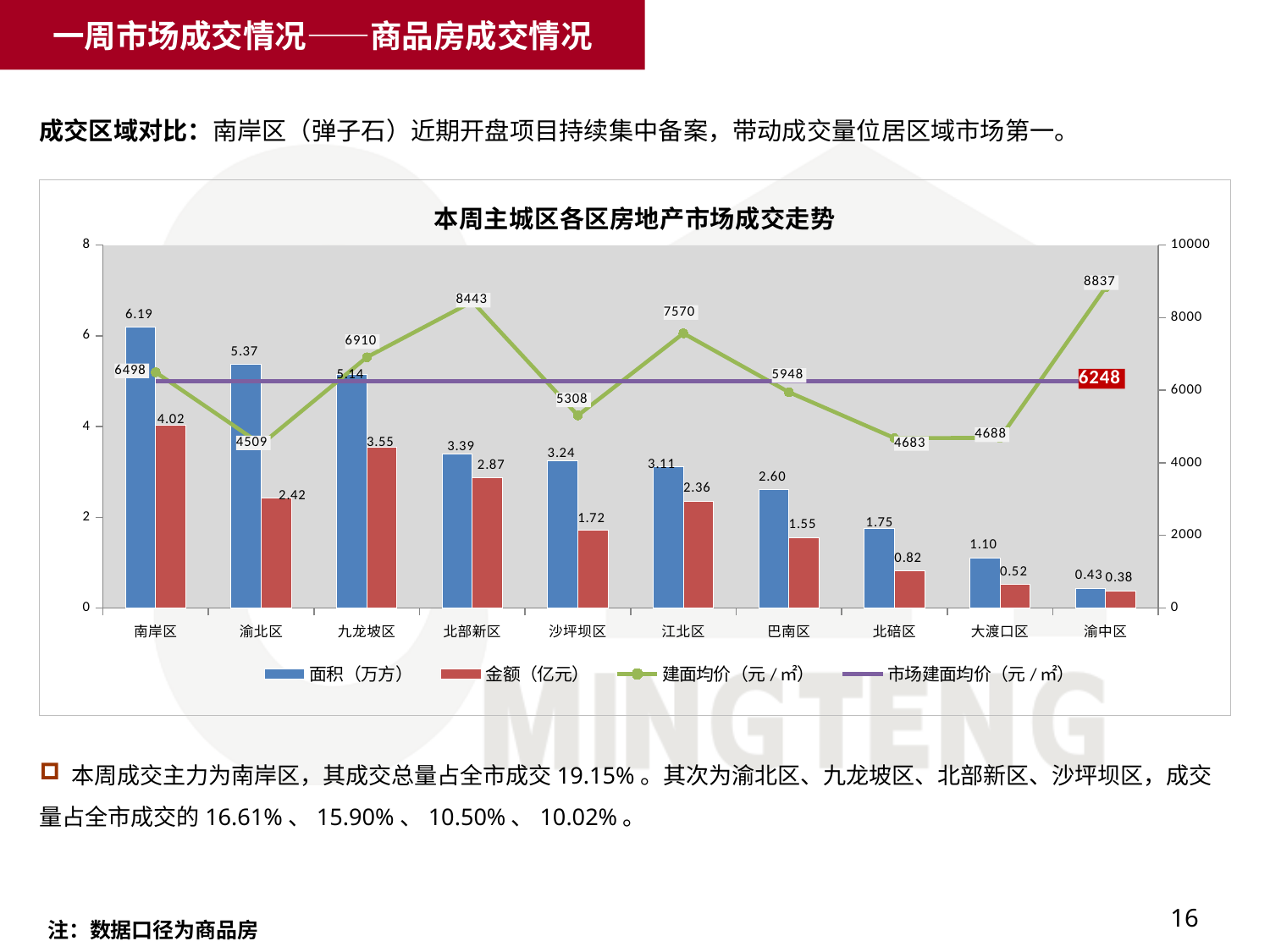
What is the value of the 市场建面均价（元/㎡） line? 6248 Which district has the highest 建面均价（元/㎡）? 渝中区 What is the 金额（亿元） value for 九龙坡区? 3.55 How many series does the legend list? 4 What kind of chart is this? Combined bar and line chart What is the 建面均价（元/㎡） value for 北部新区? 8443 What is the title of the chart? 本周主城区各区房地产市场成交走势 What is the difference between the 面积（万方） values for 南岸区 and 渝北区? 0.82 How many districts are shown on the x axis? 10 Which is larger, the 金额（亿元） for 渝北区 or for 北部新区? 北部新区 Which district has the lowest 面积（万方）? 渝中区 What is the 面积（万方） value for 南岸区? 6.19